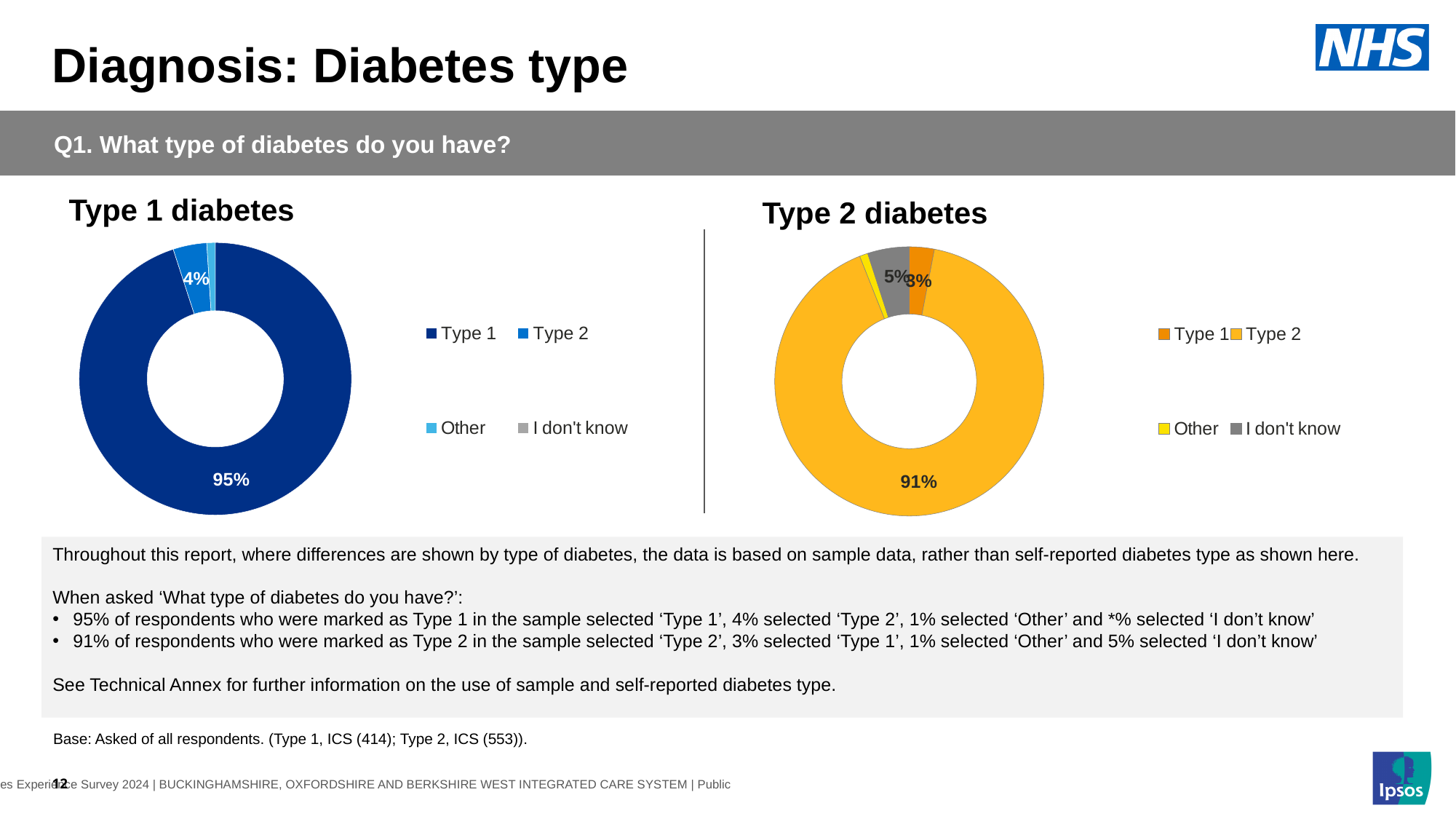
In the Type 2 diabetes chart, what percentage of respondents selected 'Type 2'? 91% In the Type 2 diabetes chart, which is larger: the 'I don't know' share or the 'Type 1' share? I don't know In the Type 2 diabetes chart, what percentage of respondents selected 'I don't know'? 5% In the Type 1 diabetes chart, what percentage of respondents selected 'Type 2'? 4% In the Type 1 diabetes chart, what percentage of respondents selected 'Type 1'? 95% In the Type 1 diabetes chart, which category has the largest share? Type 1 What kind of chart is used for the Type 2 diabetes data? Doughnut (pie) chart In the Type 2 diabetes chart, which category has the largest share? Type 2 In the Type 2 diabetes chart, what percentage of respondents selected 'Type 1'? 3% In the Type 2 diabetes chart, what colour represents 'Other'? Yellow How many entries does the legend of the Type 1 diabetes chart list? 4 In the Type 1 diabetes chart, what is the difference between the 'Type 1' and 'Type 2' shares? 91 percentage points